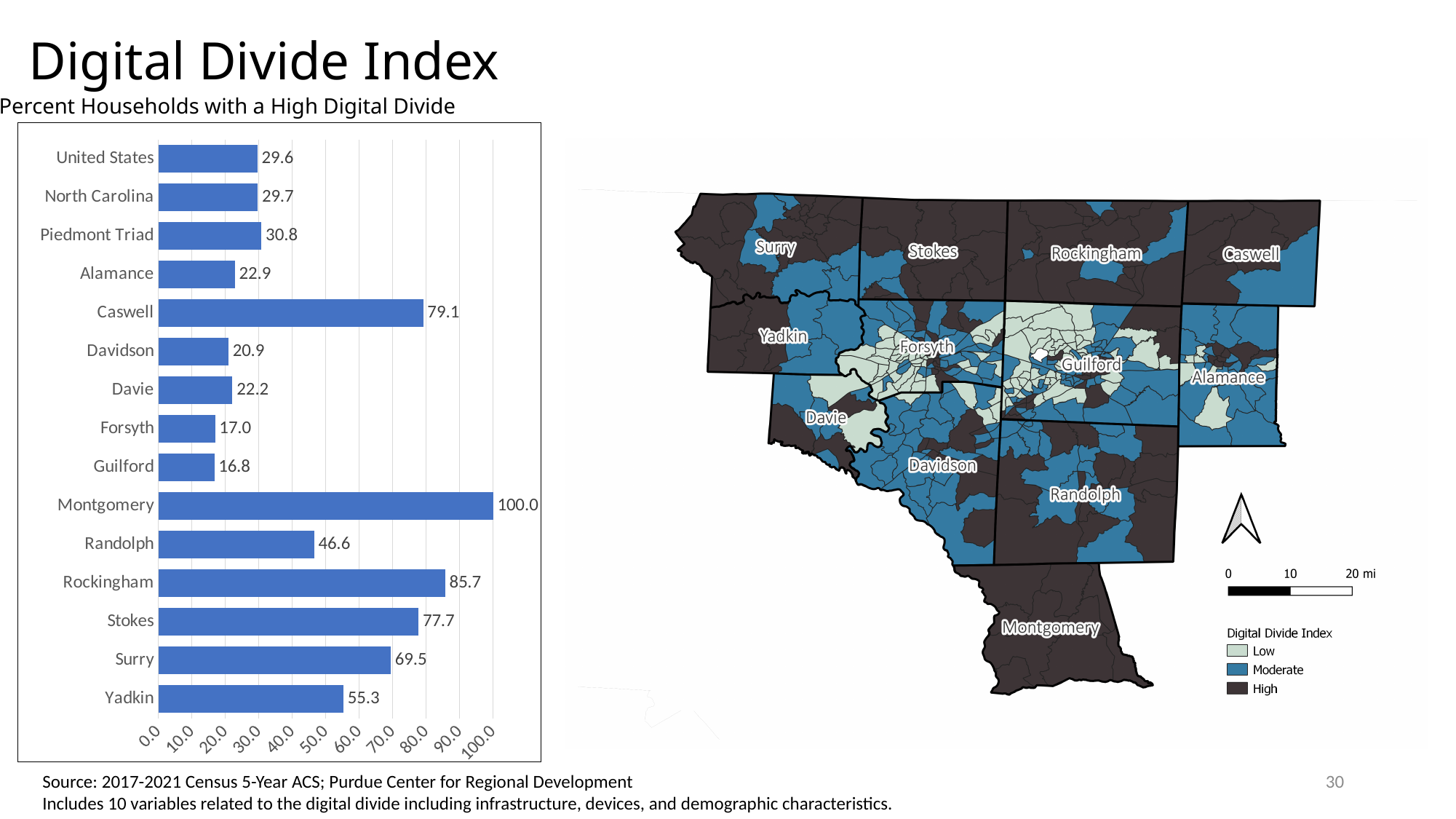
What is the value for Caswell in the bar chart? 79.1 Which category has the lowest value in the bar chart? Guilford How many categories are shown in the bar chart? 15 What is the difference between the values for Rockingham and Stokes in the bar chart? 8.0 In the bar chart, is the value for Randolph greater or less than 40.0? greater What is the difference between the values for Montgomery and Caswell in the bar chart? 20.9 What three categories does the map's Digital Divide Index legend list? Low, Moderate, High What is the value for the United States in the bar chart? 29.6 In the bar chart, which is larger, the value for Surry or the value for Yadkin? Surry Which category has the highest value in the bar chart? Montgomery What is the value for Rockingham in the bar chart? 85.7 What kind of chart is used to show Percent Households with a High Digital Divide? bar chart